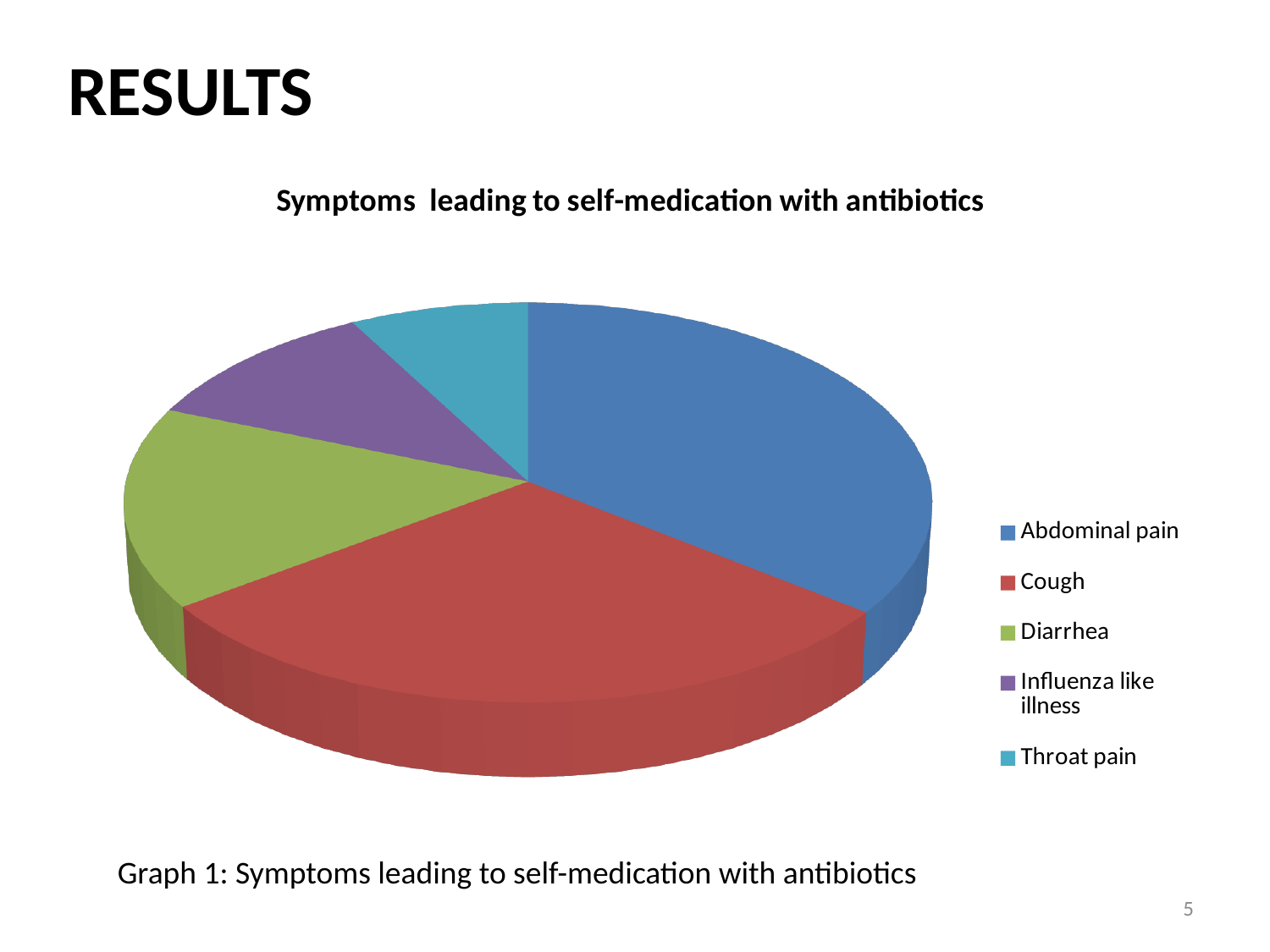
What kind of chart is shown on the slide? Pie chart Which is larger in the pie chart, the slice for Cough or the slice for Diarrhea? Cough Which is larger in the pie chart, the slice for Cough or the slice for Throat pain? Cough Which is larger in the pie chart, the slice for Diarrhea or the slice for Influenza like illness? Diarrhea How many categories (slices) does the pie chart show? 5 What is the title of the pie chart? Symptoms leading to self-medication with antibiotics How many entries does the legend of the pie chart list? 5 Which colour represents Diarrhea in the pie chart? Green